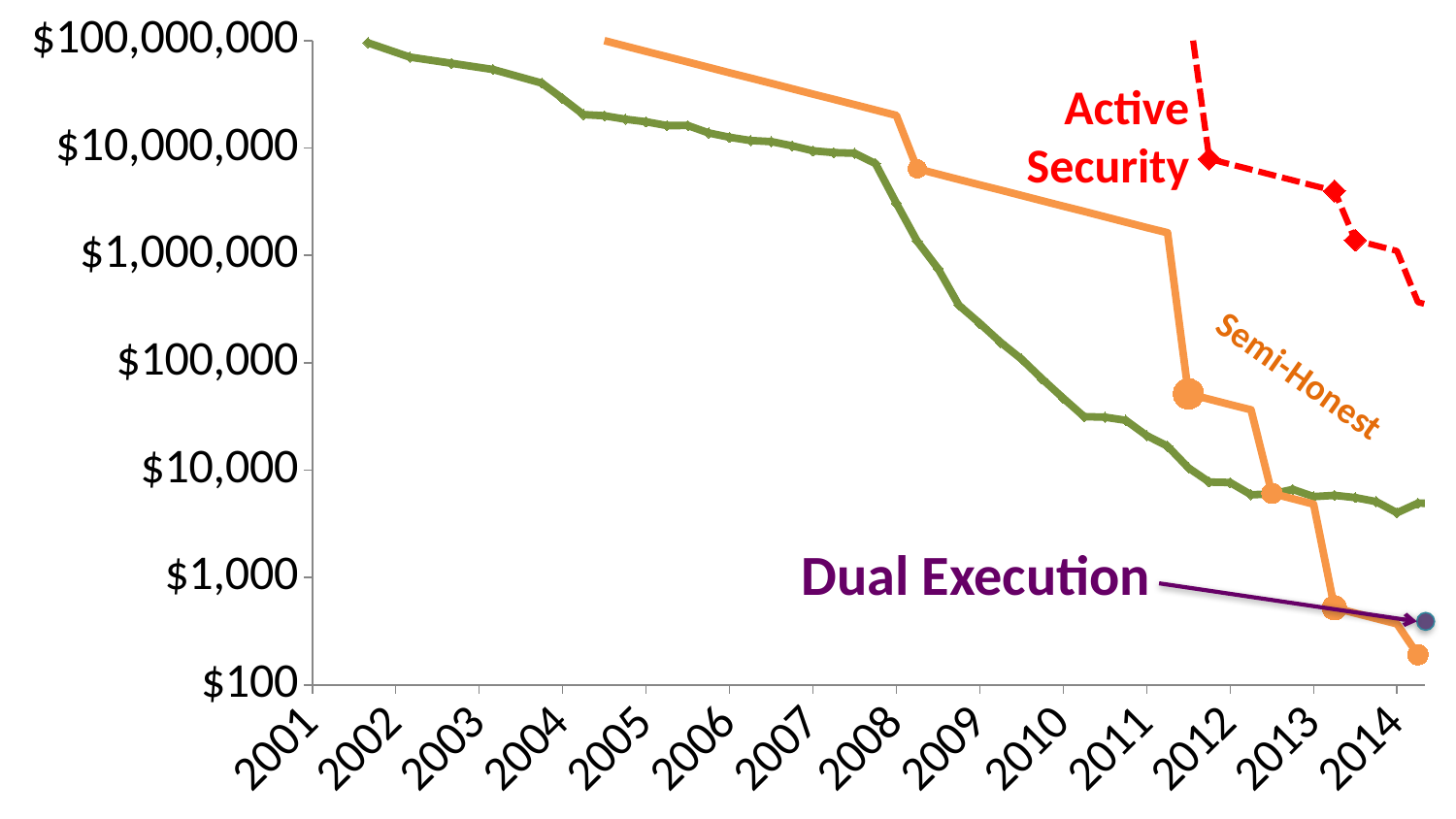
What kind of chart is shown on the slide? line chart Is the Semi-Honest value at 2012 greater or less than $10,000? greater Which series is drawn with a dashed line? Active Security Does the Active Security line rise or fall from 2012 to 2014? fall Is the Semi-Honest value at 2014 greater or less than $1,000? less At 2013, which series has the higher value, Active Security or Semi-Honest? Active Security Does the Semi-Honest line rise or fall from 2005 to 2014? fall How many years are labeled on the x axis? 14 What is the highest value labeled on the y axis? $100,000,000 Is the Active Security value at 2012 greater or less than $1,000,000? greater